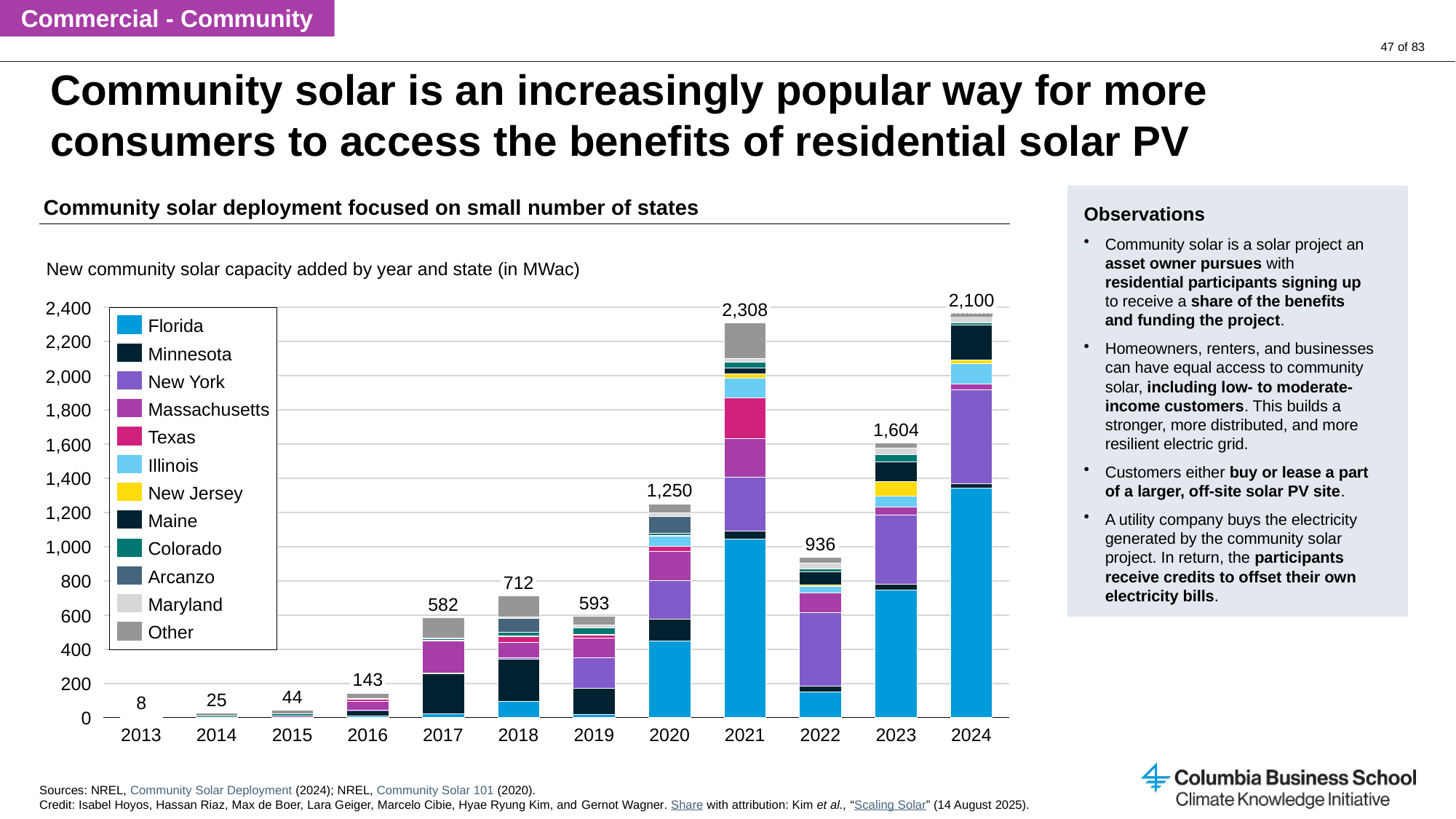
What kind of chart is shown on the slide? Stacked bar chart Which year had the highest total new community solar capacity added? 2021 What was the total new community solar capacity added in 2021? 2,308 What was the total new community solar capacity added in 2017? 582 Which year had a larger total capacity added, 2018 or 2019? 2018 How much larger was the total capacity added in 2021 than in 2020? 1,058 Which year had the lowest total new community solar capacity added? 2013 What is the difference between the total capacity added in 2023 and in 2022? 668 How many series does the legend list? 12 Is the Florida capacity added in 2023 greater or less than 600? greater Did the total capacity added rise or fall from 2013 to 2017? Rise How many years are shown on the x axis of the chart? 12